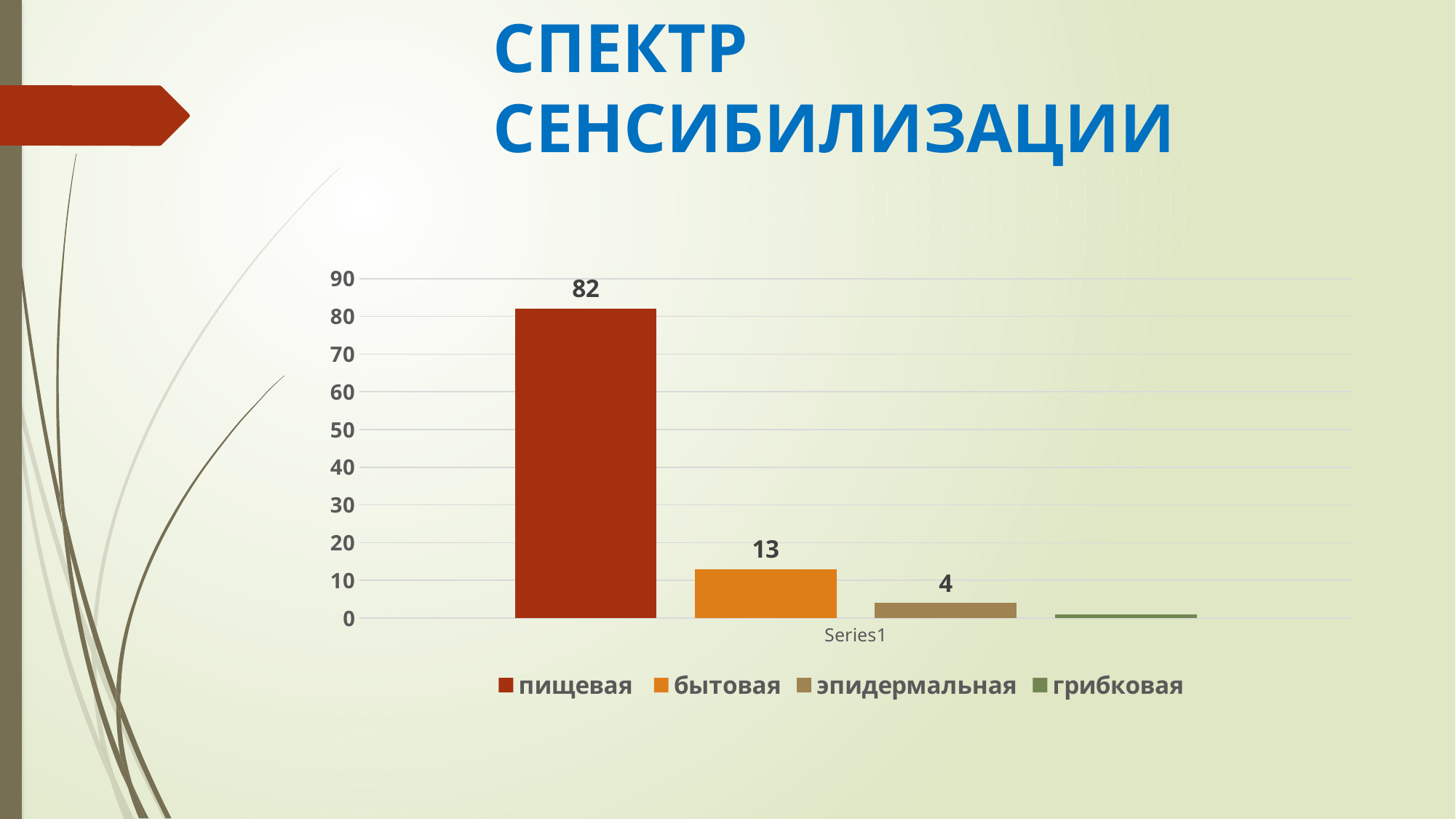
How many series does the legend list? 4 Which series has the highest value? пищевая What is the value for бытовая? 13 Which series has the lowest value? грибковая What is the difference between the values for бытовая and эпидермальная? 9 What is the value for пищевая? 82 What is the difference between the values for пищевая and бытовая? 69 Which is larger, the value for бытовая or the value for эпидермальная? бытовая What kind of chart is shown on the slide? bar chart What is the title of the slide? СПЕКТР СЕНСИБИЛИЗАЦИИ Is the value for грибковая greater or less than 10? less What is the value for эпидермальная? 4